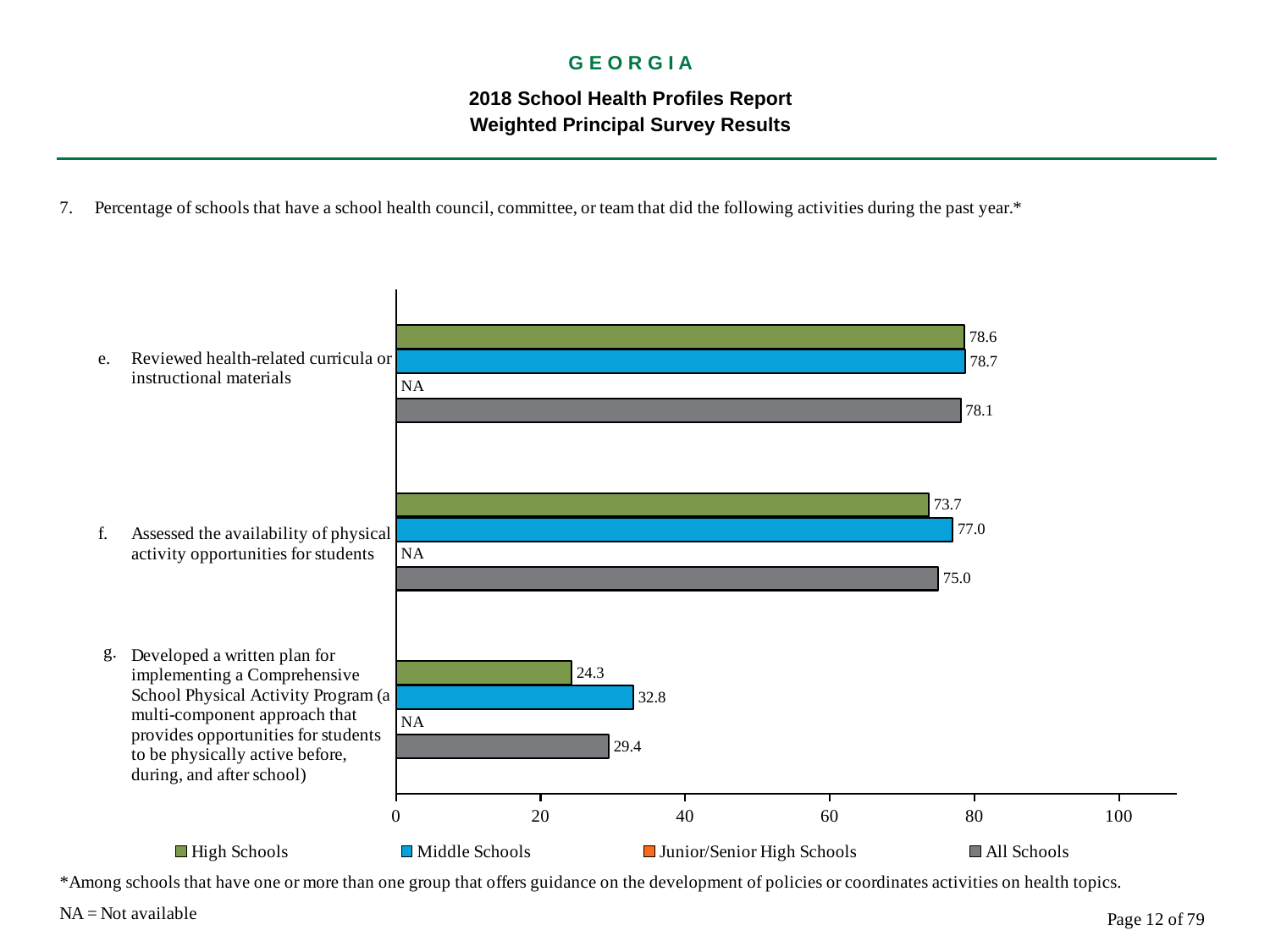
What colour represents Middle Schools in the legend? blue For 'Assessed the availability of physical activity opportunities for students', which is larger: the High Schools value or the Middle Schools value? Middle Schools How many series does the legend list? 4 What is the value for High Schools for 'Reviewed health-related curricula or instructional materials'? 78.6 What is the value for All Schools for 'Developed a written plan for implementing a Comprehensive School Physical Activity Program'? 29.4 Which activity has the highest value for All Schools? Reviewed health-related curricula or instructional materials What is the difference between the Middle Schools and High Schools values for 'Developed a written plan for implementing a Comprehensive School Physical Activity Program'? 8.5 Is the All Schools value for 'Assessed the availability of physical activity opportunities for students' greater or less than 60? greater Which activity has the lowest value for Middle Schools? Developed a written plan for implementing a Comprehensive School Physical Activity Program What is the value for Middle Schools for 'Assessed the availability of physical activity opportunities for students'? 77.0 What kind of chart is shown on the slide? bar chart What value is shown for Junior/Senior High Schools for 'Assessed the availability of physical activity opportunities for students'? NA